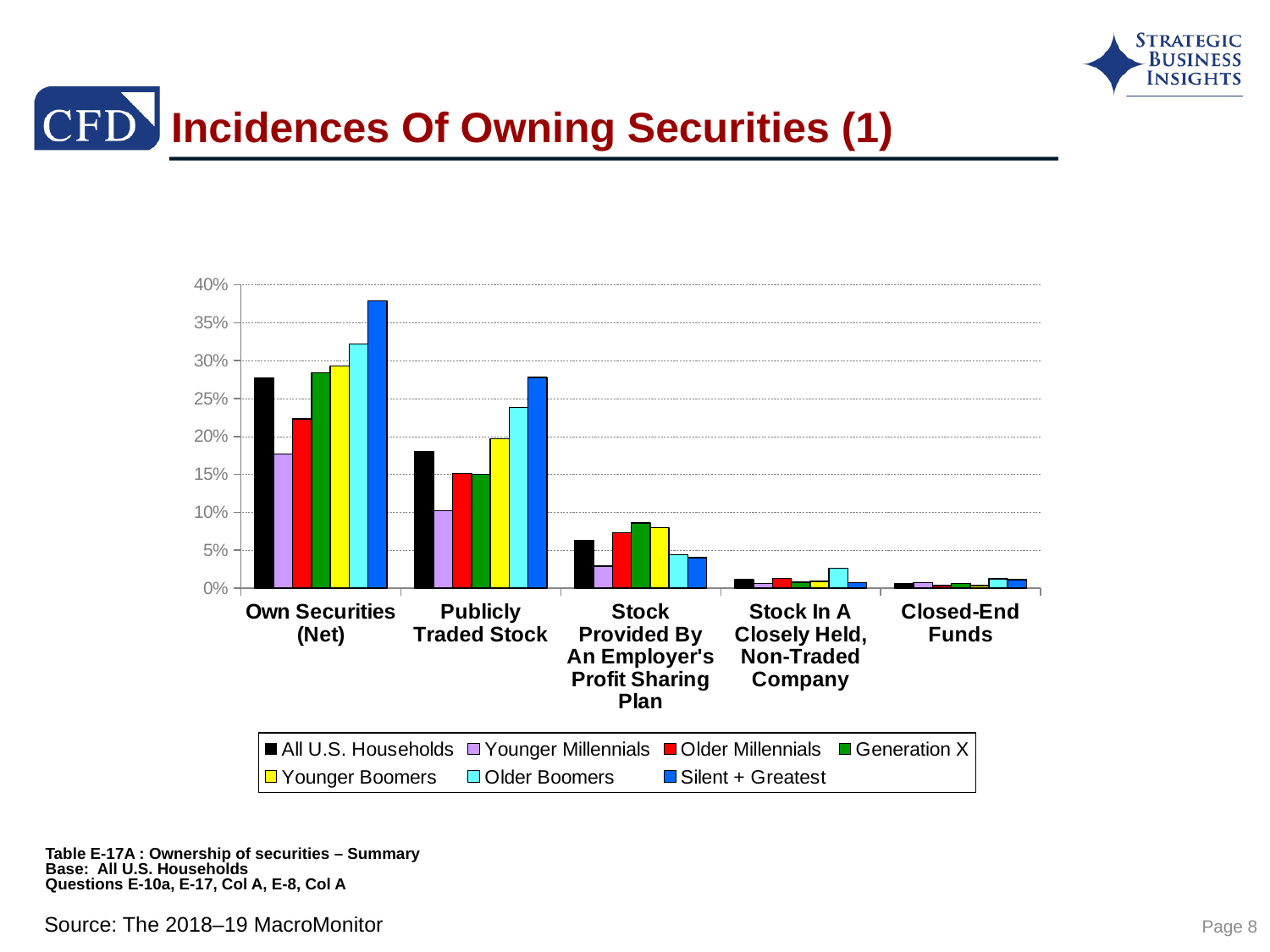
What kind of chart is shown on the slide? Bar chart What colour represents All U.S. Households in the legend? Black How many series does the legend list? 7 For Stock Provided By An Employer's Profit Sharing Plan, which series has the lowest value? Younger Millennials Is the value for All U.S. Households in Own Securities (Net) greater or less than 25%? greater Is the value for Silent + Greatest in Own Securities (Net) greater or less than 35%? greater For Own Securities (Net), which series has the highest value? Silent + Greatest For Own Securities (Net), which is larger: Older Boomers or Older Millennials? Older Boomers Is the value for Younger Millennials in Publicly Traded Stock greater or less than 15%? less Do the values for All U.S. Households rise or fall moving from left to right across the categories? fall How many categories are shown on the x axis? 5 For Publicly Traded Stock, which series has the lowest value? Younger Millennials